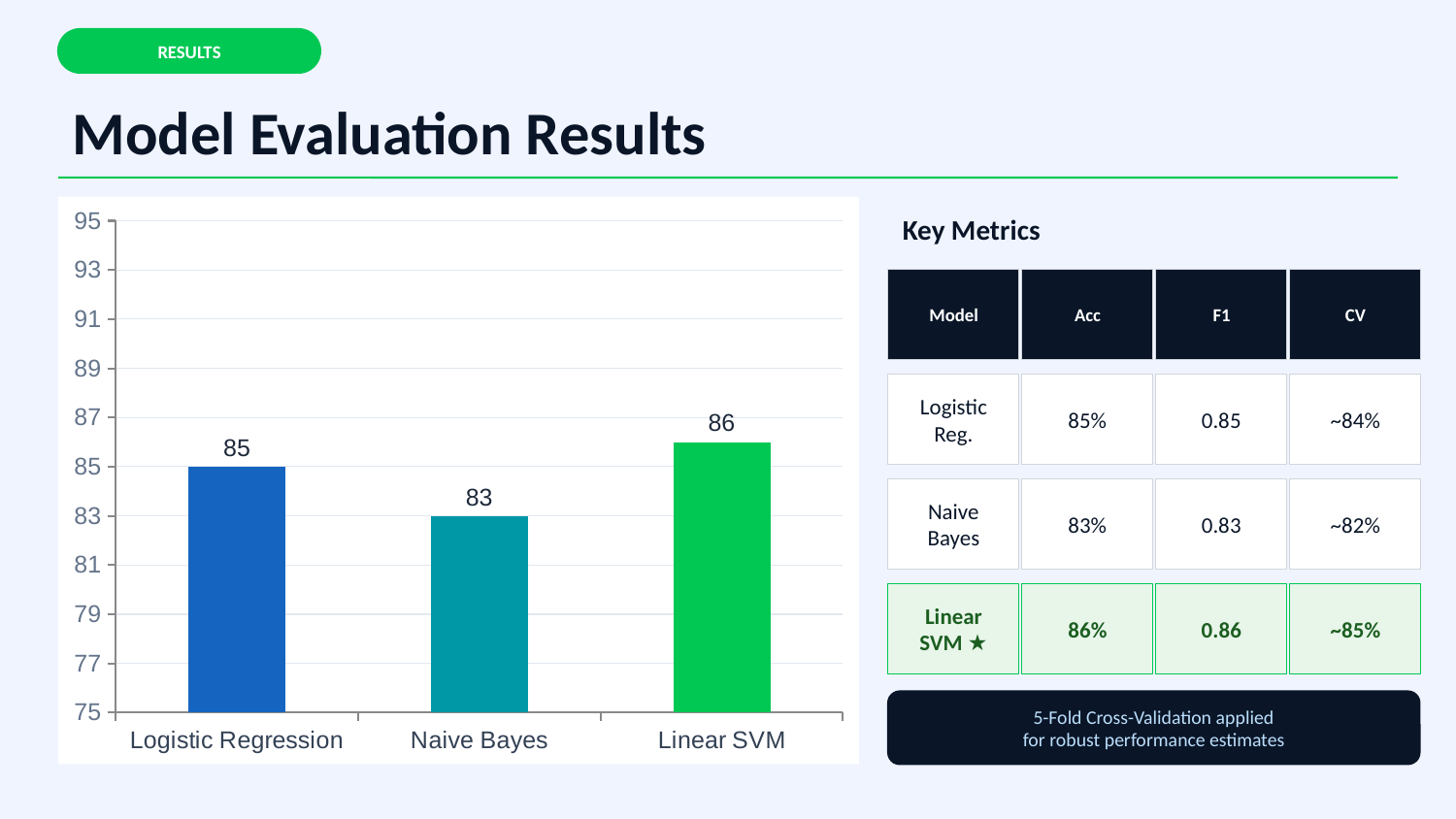
Which model has the highest value in the bar chart? Linear SVM Which model has the lowest value in the bar chart? Naive Bayes What kind of chart is shown on the slide? bar chart What is the value for Naive Bayes in the bar chart? 83 What is the difference between the values for Logistic Regression and Naive Bayes in the bar chart? 2 What colour is the bar for Linear SVM in the bar chart? green Is the value for Naive Bayes in the bar chart greater or less than 85? less What is the value for Logistic Regression in the bar chart? 85 Which is larger in the bar chart, the value for Logistic Regression or the value for Naive Bayes? Logistic Regression What is the difference between the values for Linear SVM and Naive Bayes in the bar chart? 3 How many models are shown in the bar chart? 3 What is the value for Linear SVM in the bar chart? 86